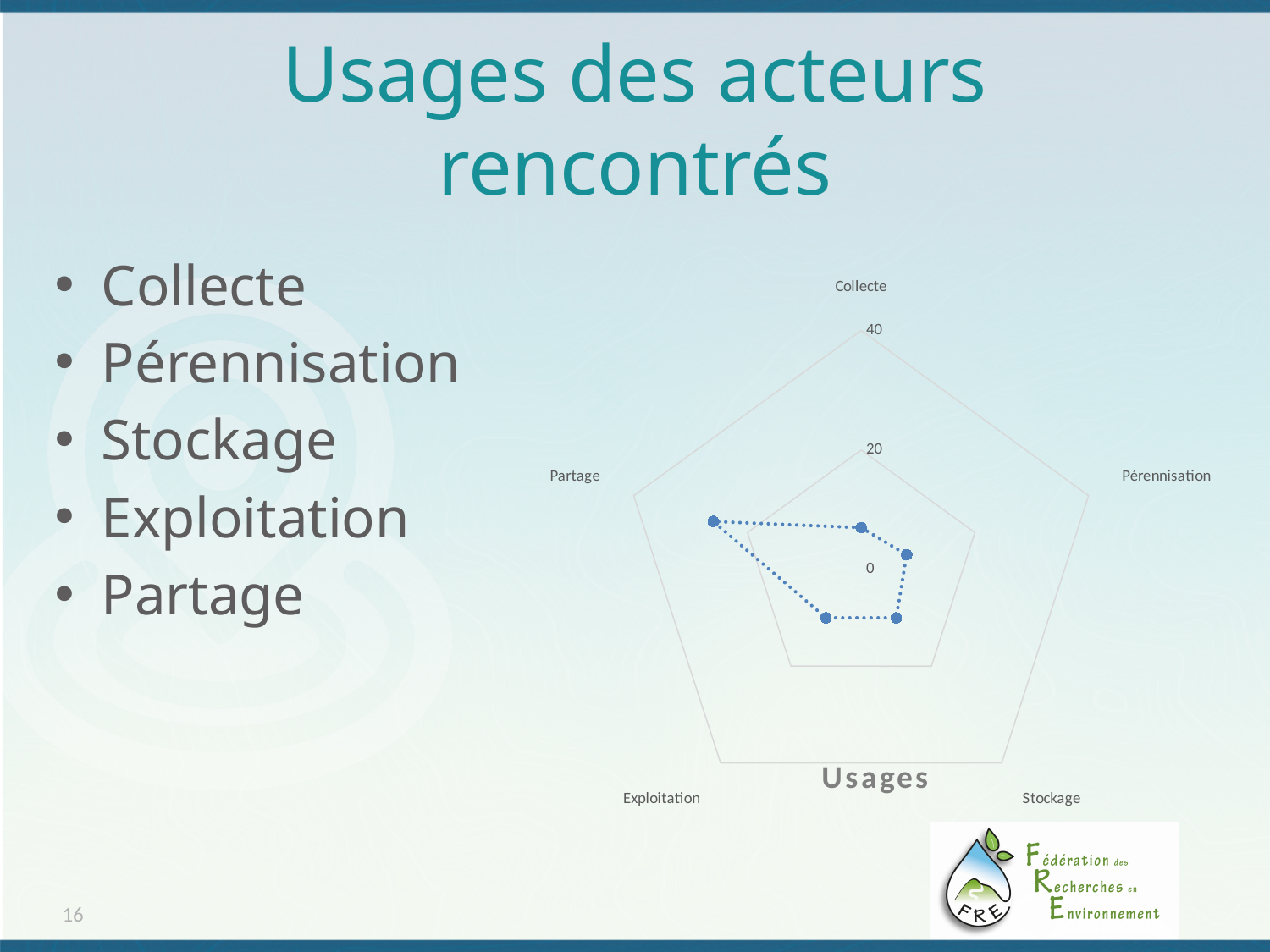
Which is larger, the value for Partage or the value for Pérennisation? Partage Is the value for Collecte greater or less than 20? less What kind of chart is shown on the slide? radar chart Which is larger, the value for Partage or the value for Collecte? Partage What is the maximum value shown on the chart's axis scale? 40 What is the title of the chart? Usages Is the value for Partage greater or less than 20? greater Is the value for Exploitation greater or less than 20? less How many categories (axes) does the radar chart have? 5 Which category has the highest value in the chart? Partage